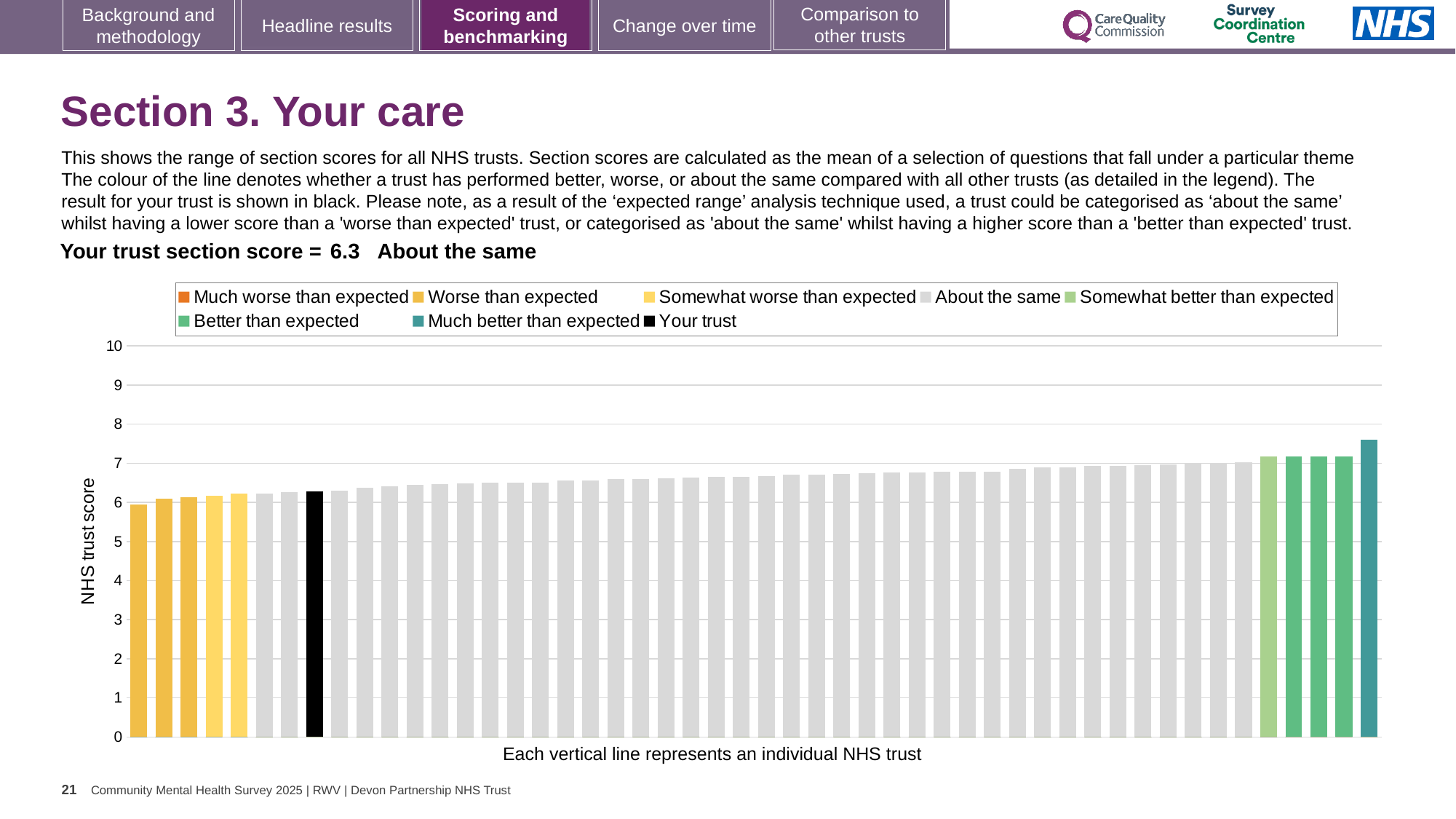
Do the bar values rise or fall from left to right along the x axis? rise Is the value of the tallest bar (the 'Much better than expected' trust) greater or less than 7? greater What kind of chart is shown on the slide? bar chart Is the value of the tallest bar greater or less than 8? less Which legend category does the highest bar belong to? Much better than expected Is the value of the black 'Your trust' bar greater or less than 7? less How many entries does the chart legend list? 8 What is the label on the vertical axis of the chart? NHS trust score Which category is your trust's section score placed in? About the same What is the section score for your trust as printed on the slide? 6.3 How many bars are coloured as 'Much better than expected'? 1